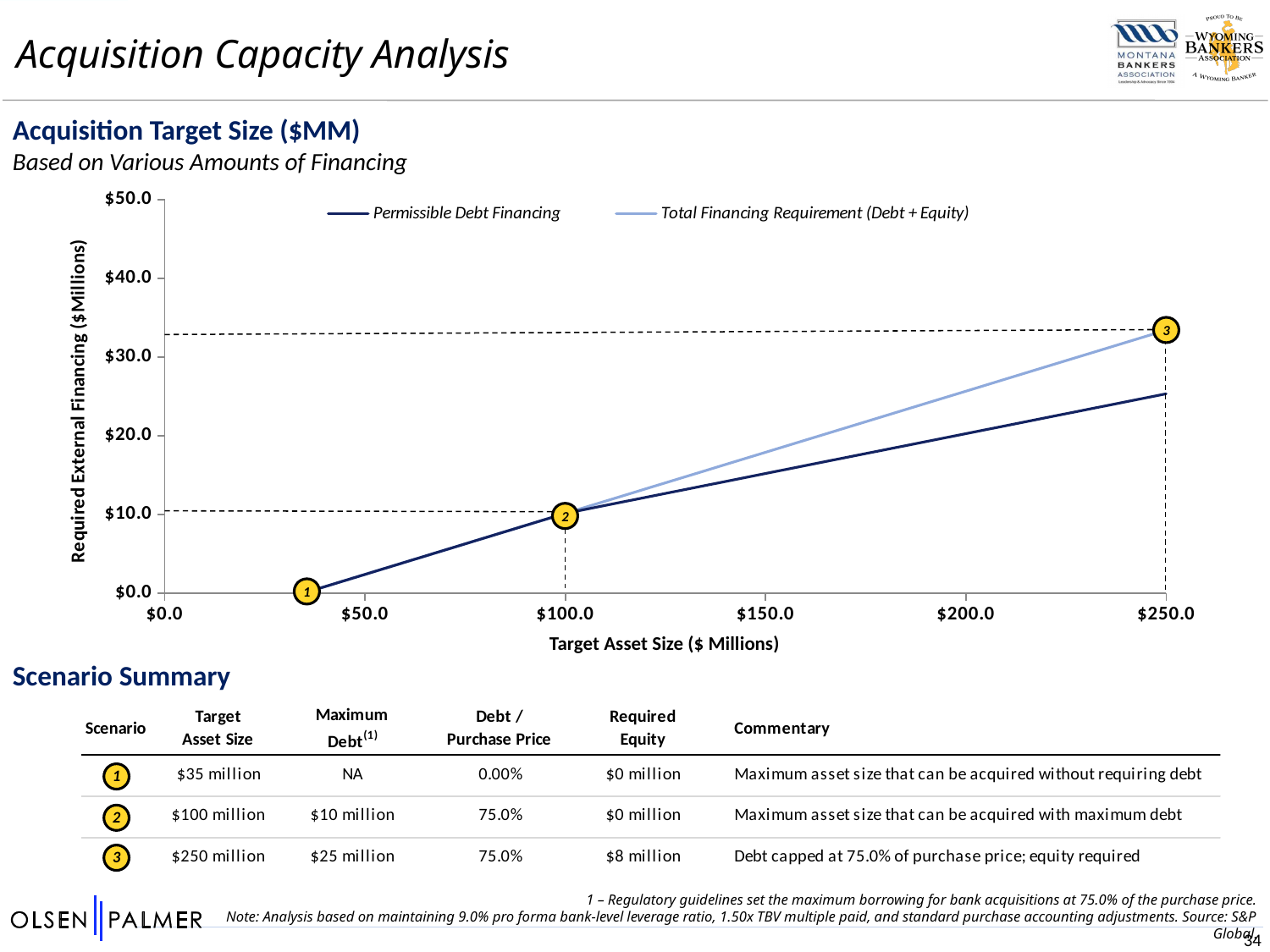
Is the value of Permissible Debt Financing at a Target Asset Size of $150.0 greater or less than $20.0? less Is the value of Total Financing Requirement (Debt + Equity) at a Target Asset Size of $200.0 greater or less than $20.0? greater At a Target Asset Size of $250.0, which series has the higher value: Permissible Debt Financing or Total Financing Requirement (Debt + Equity)? Total Financing Requirement (Debt + Equity) How many series does the chart legend list? 2 Is the value of Total Financing Requirement (Debt + Equity) at a Target Asset Size of $250.0 greater or less than $30.0? greater How many numbered scenario points are marked on the chart? 3 What kind of chart is shown on the slide? line chart What is the title of the chart's x axis? Target Asset Size ($ Millions) What is the value of Permissible Debt Financing at a Target Asset Size of $100.0? $10.0 Do the values of Total Financing Requirement (Debt + Equity) rise or fall as Target Asset Size increases? rise What are the two series named in the chart legend? Permissible Debt Financing; Total Financing Requirement (Debt + Equity)